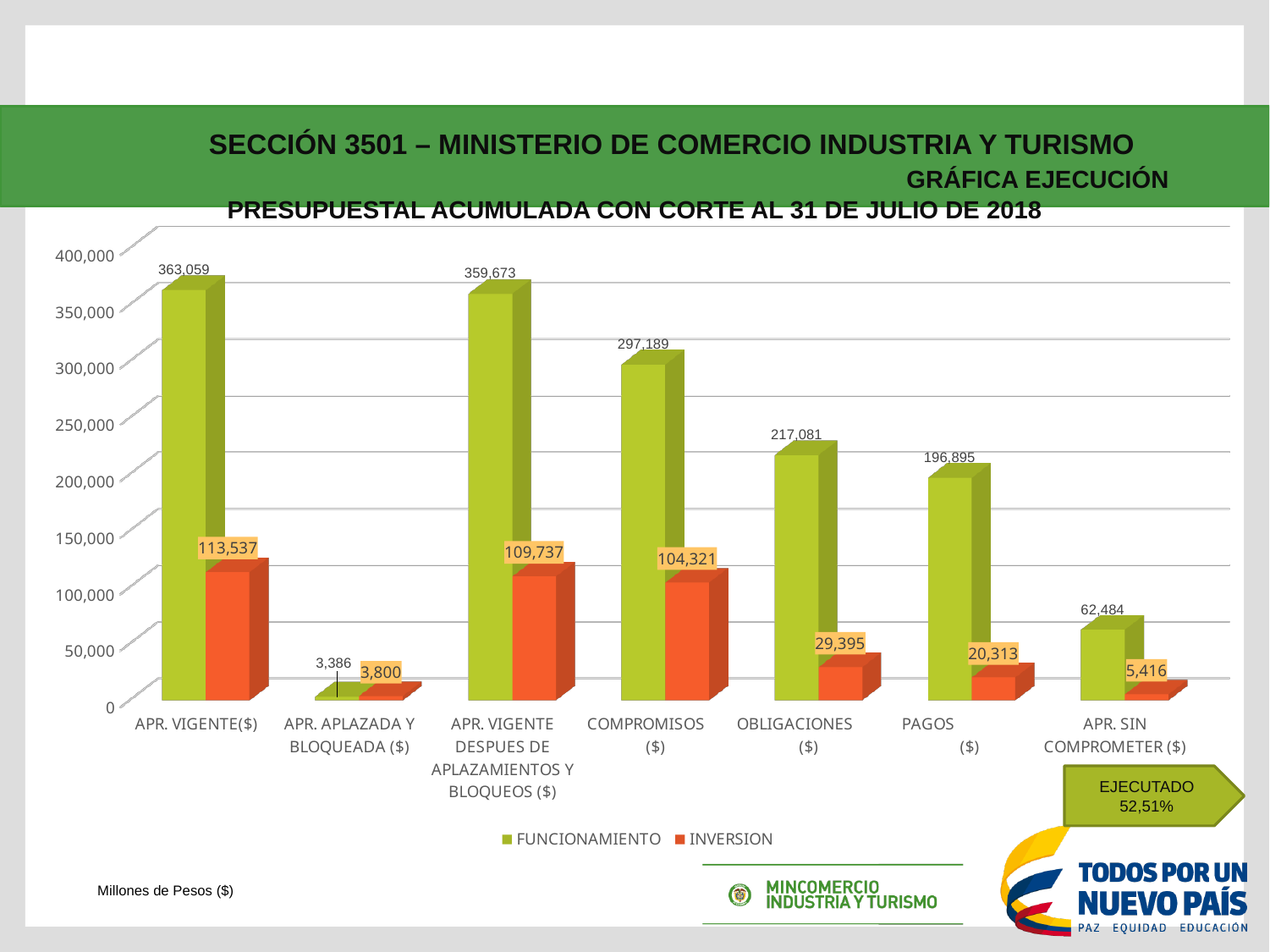
How many categories are shown on the x axis? 7 Which category has the highest FUNCIONAMIENTO value? APR. VIGENTE($) Which series is shown in orange in the legend? INVERSION How many series does the legend list? 2 Which is larger for APR. APLAZADA Y BLOQUEADA ($): FUNCIONAMIENTO or INVERSION? INVERSION What is the INVERSION value for COMPROMISOS ($)? 104,321 What is the FUNCIONAMIENTO value for APR. SIN COMPROMETER ($)? 62,484 What is the difference between the FUNCIONAMIENTO values for COMPROMISOS ($) and OBLIGACIONES ($)? 80,108 Which category has the lowest INVERSION value? APR. APLAZADA Y BLOQUEADA ($) What is the INVERSION value for PAGOS ($)? 20,313 What kind of chart is shown on the slide? Bar chart What is the FUNCIONAMIENTO value for APR. VIGENTE($)? 363,059